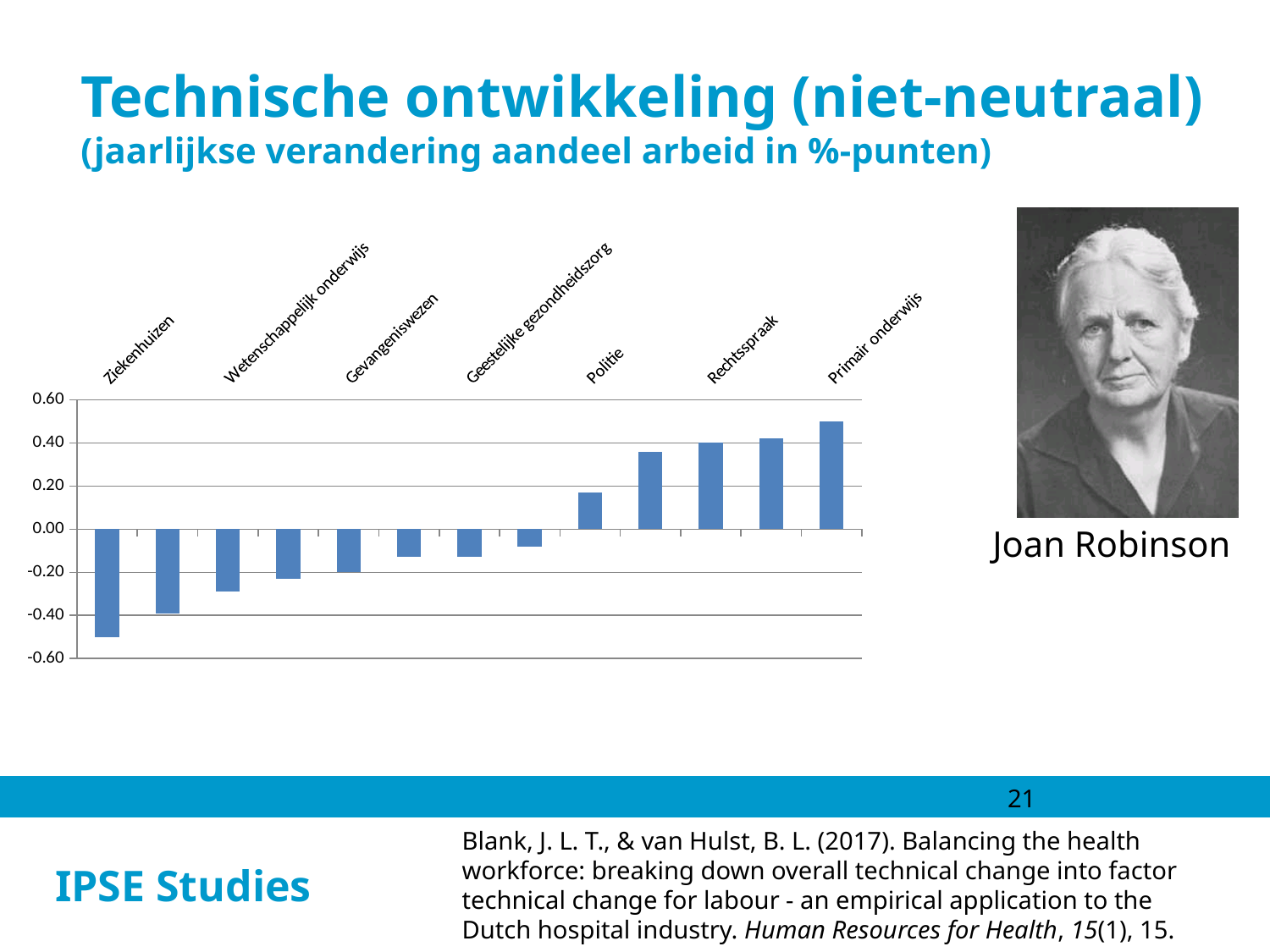
Which labelled category has the lowest value in the chart? Ziekenhuizen Is the value for Geestelijke gezondheidszorg greater or less than -0.20? greater Is the value for Ziekenhuizen greater or less than -0.40? less Which is larger, the value for Politie or the value for Rechtsspraak? Rechtsspraak What kind of chart is shown on the slide? bar chart How many bars does the chart contain? 13 Is the value for Wetenschappelijk onderwijs greater or less than -0.20? less Which labelled category has the highest value in the chart? Primair onderwijs How many bars in the chart have a negative value? 8 Do the bar values rise or fall from left to right along the x axis? rise